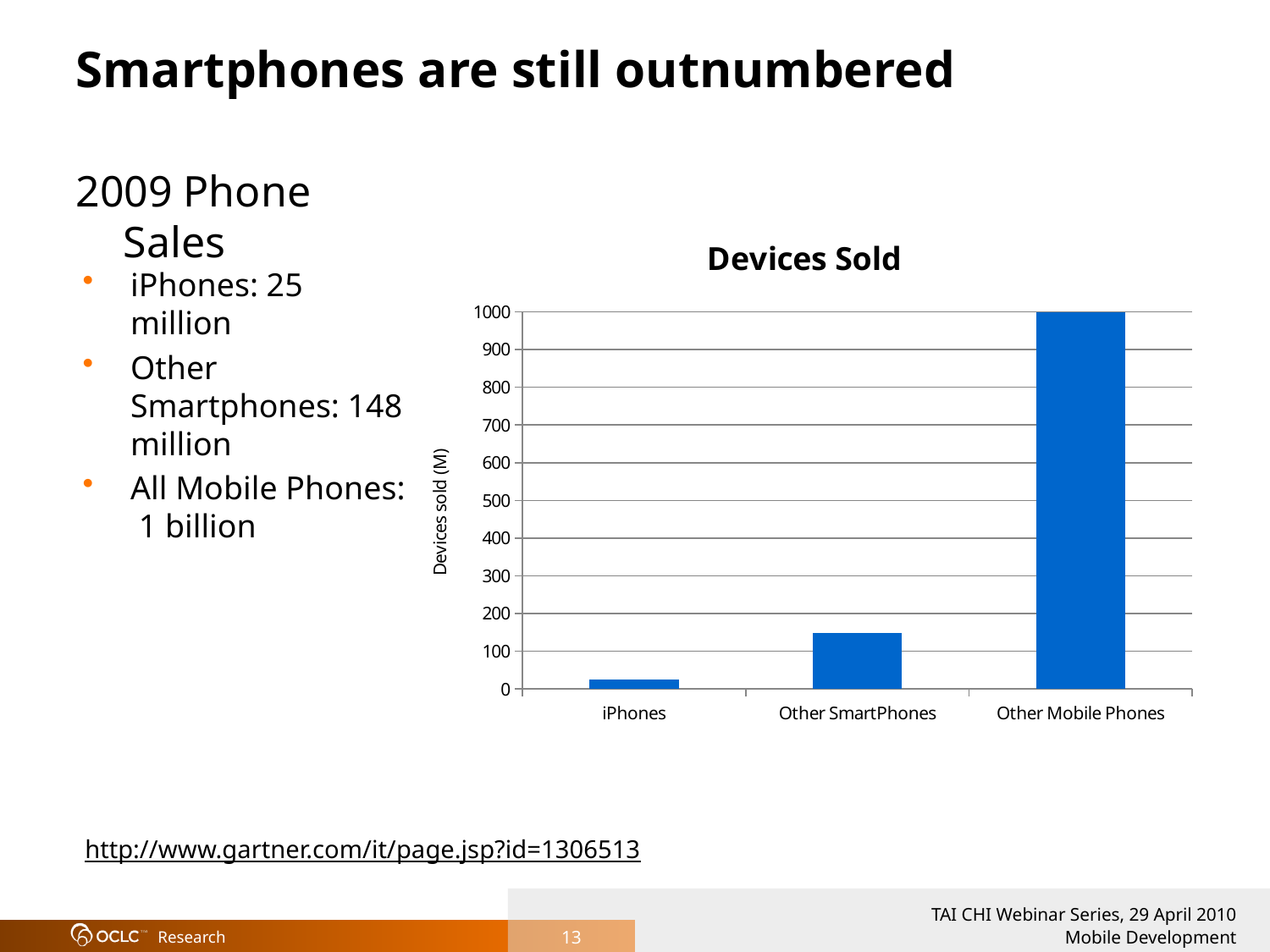
Is the value for iPhones greater or less than 100? less Is the value for Other SmartPhones greater or less than 200? less Which is larger, the value for Other SmartPhones or the value for iPhones? Other SmartPhones Is the value for Other Mobile Phones greater or less than 900? greater Which category has the highest value in the Devices Sold chart? Other Mobile Phones What is the label on the vertical axis of the chart? Devices sold (M) What kind of chart is shown on the slide? bar chart Which category has the lowest value in the Devices Sold chart? iPhones How many categories are plotted in the Devices Sold chart? 3 What is the title of the chart? Devices Sold